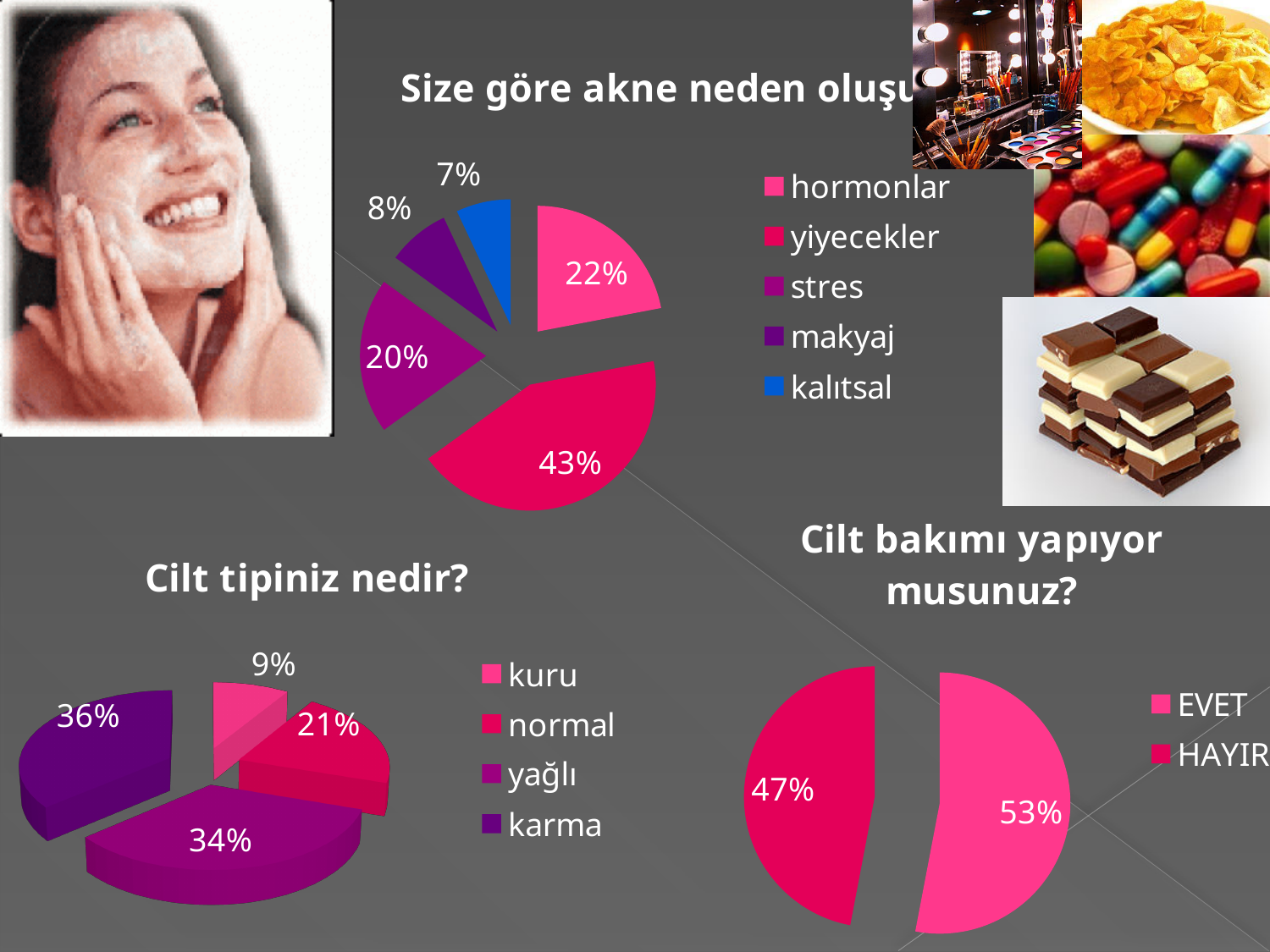
In the top pie chart about acne causes, what percentage is shown for yiyecekler? 43% In the 'Cilt tipiniz nedir?' chart, which is larger, normal or kuru? normal What kind of chart is the 'Cilt tipiniz nedir?' chart? pie chart In the top pie chart about acne causes, what colour is the kalıtsal slice? blue In the top pie chart about acne causes, which category has the smallest share? kalıtsal In the 'Cilt bakımı yapıyor musunuz?' chart, what is the difference between EVET and HAYIR? 6% In the top pie chart about acne causes, which category has the largest share? yiyecekler In the 'Cilt tipiniz nedir?' chart, what percentage is shown for yağlı? 34% In the top pie chart about acne causes, how many categories does the legend list? 5 In the 'Cilt tipiniz nedir?' chart, which skin type has the largest share? karma In the 'Cilt bakımı yapıyor musunuz?' chart, what percentage answered EVET? 53% In the top pie chart about acne causes, what is the difference between the shares for hormonlar and stres? 2%